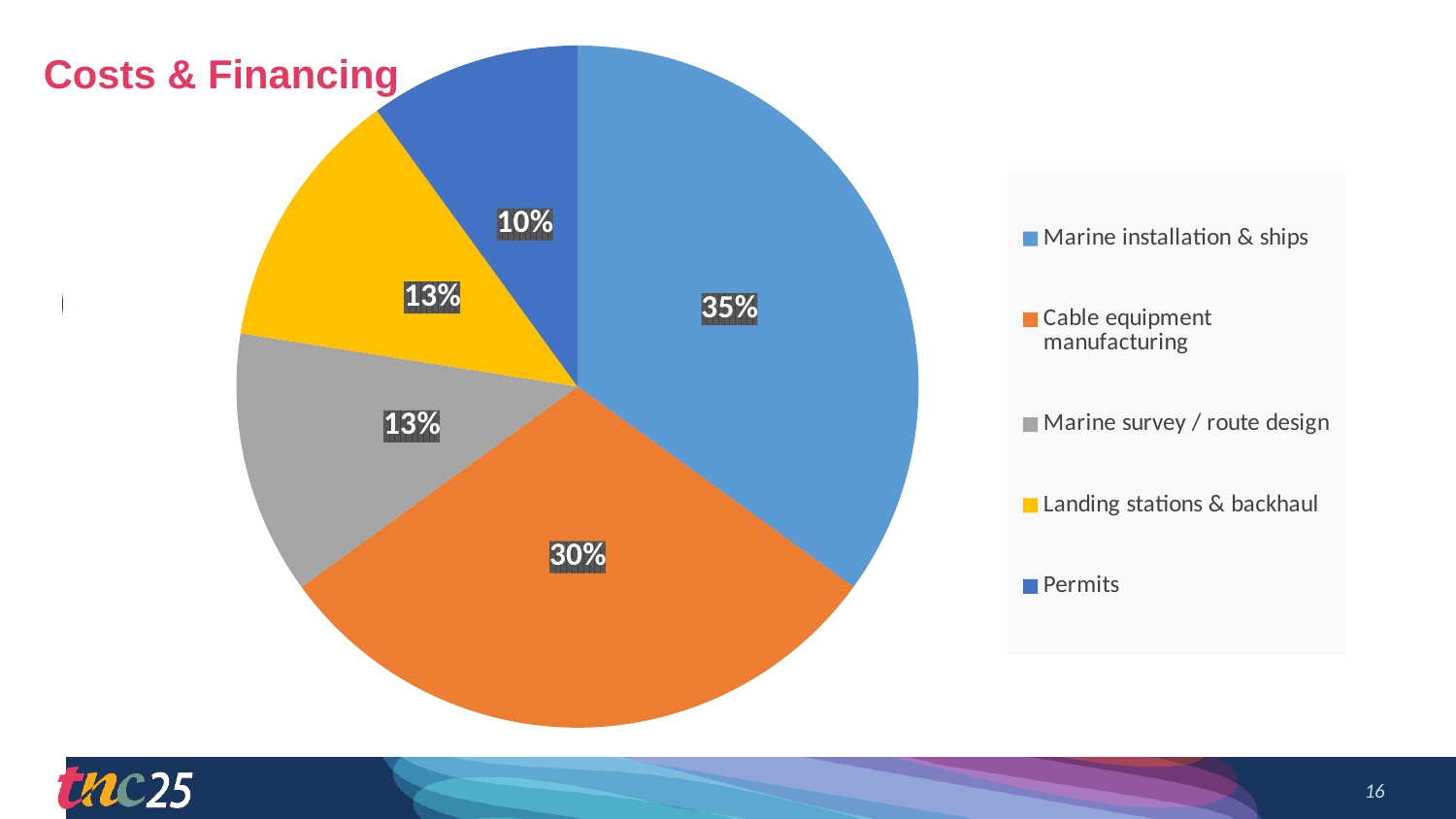
Which category has the smallest slice of the pie? Permits Which is larger, the share for Cable equipment manufacturing or the share for Marine survey / route design? Cable equipment manufacturing What share of the pie does Cable equipment manufacturing account for? 30% What share of the pie does Marine installation & ships account for? 35% What is the difference between the shares for Marine installation & ships and Cable equipment manufacturing? 5% Which category has the largest slice of the pie? Marine installation & ships What share of the pie does Permits account for? 10% What colour is the slice for Landing stations & backhaul? yellow What kind of chart is shown on the slide? pie chart What share of the pie does Landing stations & backhaul account for? 13% How many entries does the legend list? 5 How many slices does the pie chart have? 5